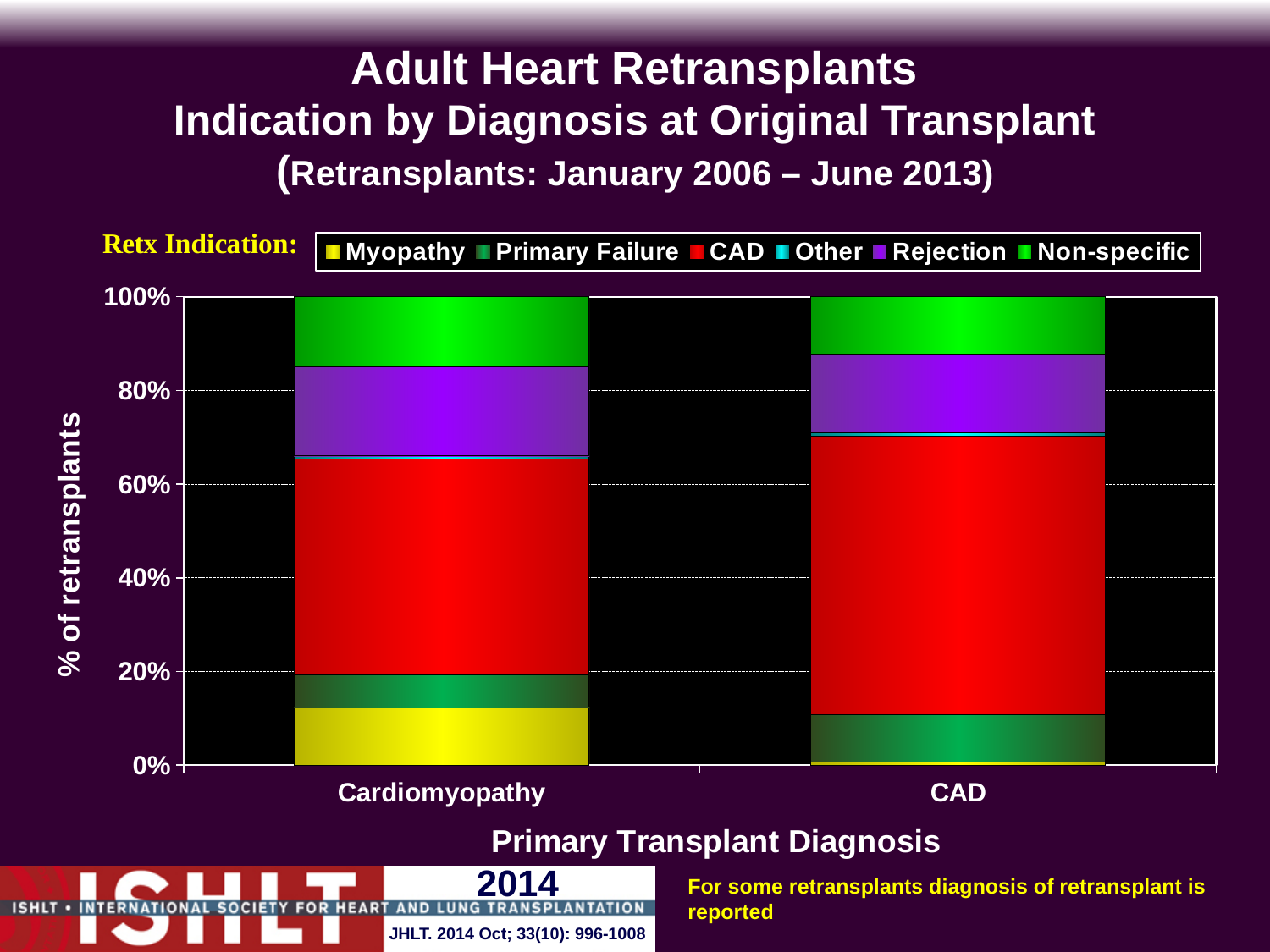
Is the Primary Failure share for CAD greater or less than 20%? less What is the label of the x axis? Primary Transplant Diagnosis Is the top of the CAD segment in the CAD bar greater or less than 60%? greater Is the Myopathy share for Cardiomyopathy greater or less than 20%? less How many categories are shown on the x axis of the chart? 2 What is the total height of the stacked bar for Cardiomyopathy? 100% How many series does the legend list? 6 Which category has the larger CAD (retransplant indication) share, Cardiomyopathy or CAD? CAD What kind of chart is shown on the slide? stacked bar chart Which category has the larger Myopathy share, Cardiomyopathy or CAD? Cardiomyopathy What is the label of the y axis? % of retransplants